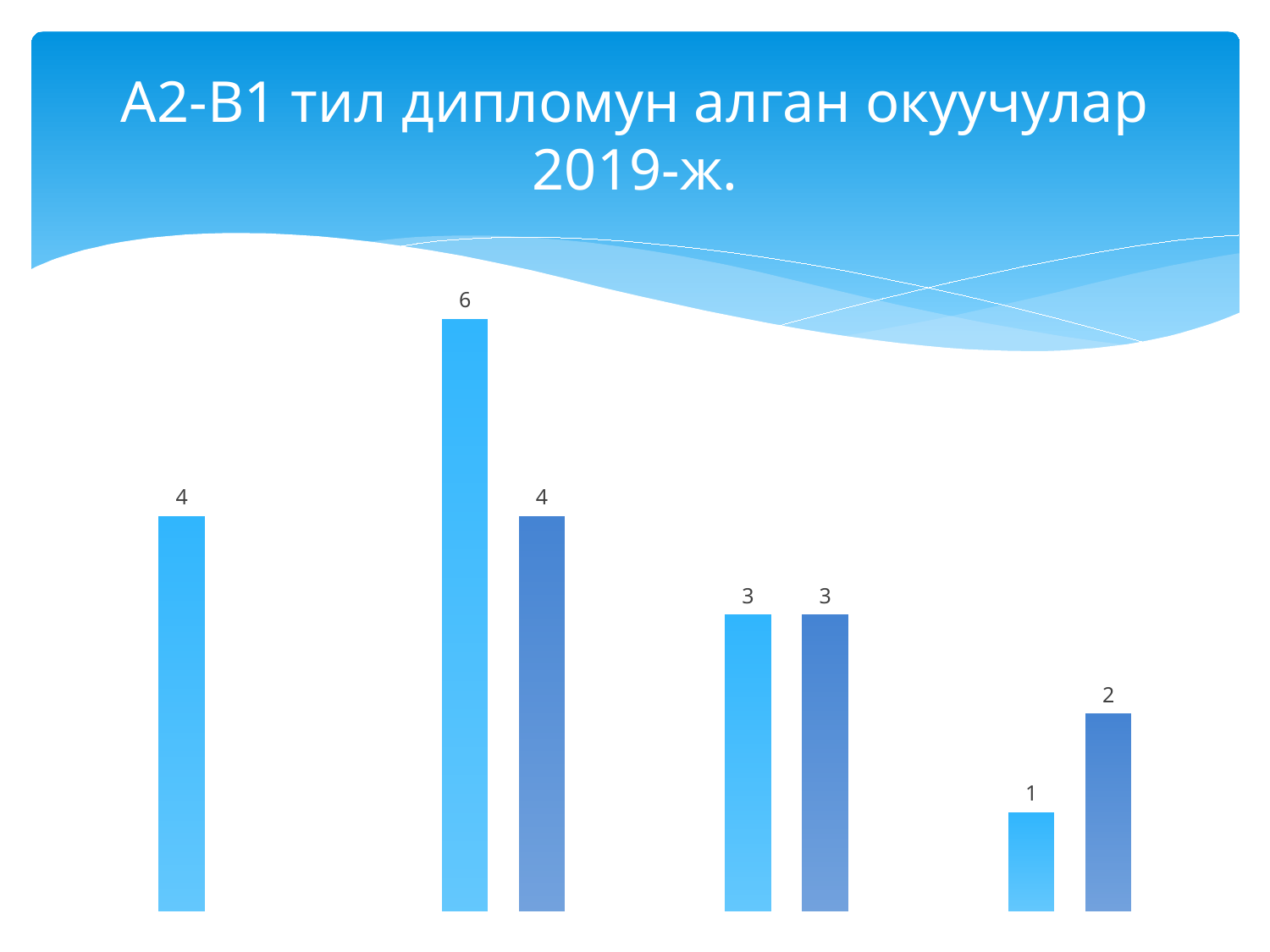
How many bars are plotted in the chart? 7 In the second group of bars from the left, which bar is larger: the light blue bar or the dark blue bar? the light blue bar What is the difference between the tallest bar (6) and the shortest bar (1) in the chart? 5 What kind of chart is shown on the slide? bar chart What is the title of the chart on the slide? А2-В1 тил дипломун алган окуучулар 2019-ж. In the rightmost pair of bars, what is the difference between the dark blue bar (2) and the light blue bar (1)? 1 What is the value of the tallest bar in the chart? 6 What is the lowest value shown by any bar in the chart? 1 What is the value of the rightmost bar in the chart? 2 What is the value of the leftmost bar in the chart? 4 How many different bar colours are used in the chart? 2 What is the highest value shown by any bar in the chart? 6